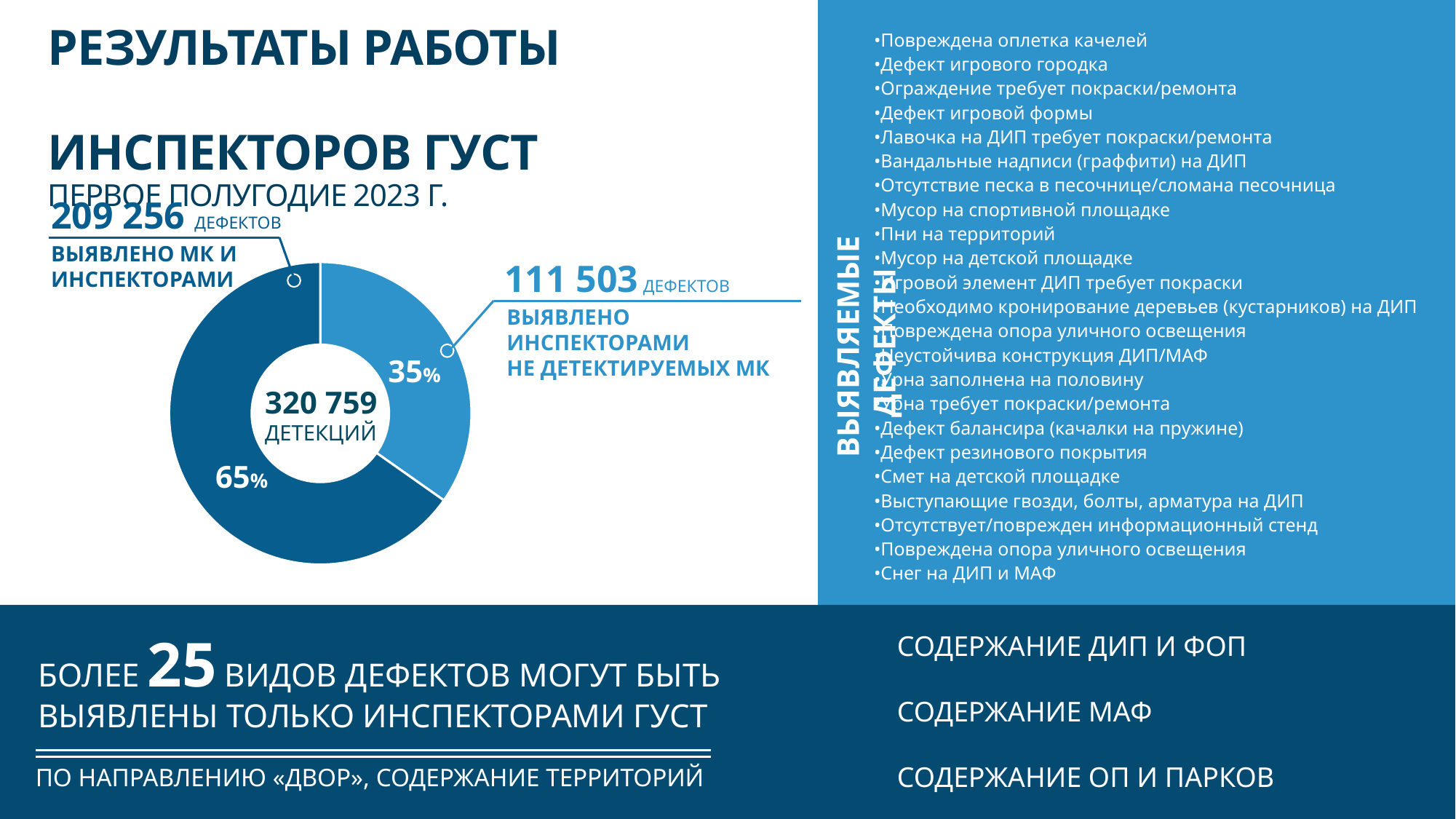
Which category has the smallest share in the donut chart? ВЫЯВЛЕНО ИНСПЕКТОРАМИ НЕ ДЕТЕКТИРУЕМЫХ МК What percentage share is shown for the slice labelled 'ВЫЯВЛЕНО ИНСПЕКТОРАМИ НЕ ДЕТЕКТИРУЕМЫХ МК'? 35% What kind of chart is shown on the slide? Donut (pie) chart What is the difference in percentage points between the two slices of the donut chart? 30 How many defects were identified by inspectors that are not detectable by MK? 111 503 What percentage share is shown for the slice labelled 'ВЫЯВЛЕНО МК И ИНСПЕКТОРАМИ'? 65% What is the difference in defect counts between the 65% slice (209 256) and the 35% slice (111 503)? 97 753 Which slice of the donut chart is larger: 'ВЫЯВЛЕНО МК И ИНСПЕКТОРАМИ' or 'ВЫЯВЛЕНО ИНСПЕКТОРАМИ НЕ ДЕТЕКТИРУЕМЫХ МК'? ВЫЯВЛЕНО МК И ИНСПЕКТОРАМИ What total number of detections is shown in the centre of the donut chart? 320 759 How many defects were identified by MK and inspectors ('ВЫЯВЛЕНО МК И ИНСПЕКТОРАМИ')? 209 256 What period does the chart's heading refer to? ПЕРВОЕ ПОЛУГОДИЕ 2023 Г. How many slices does the donut chart have? 2